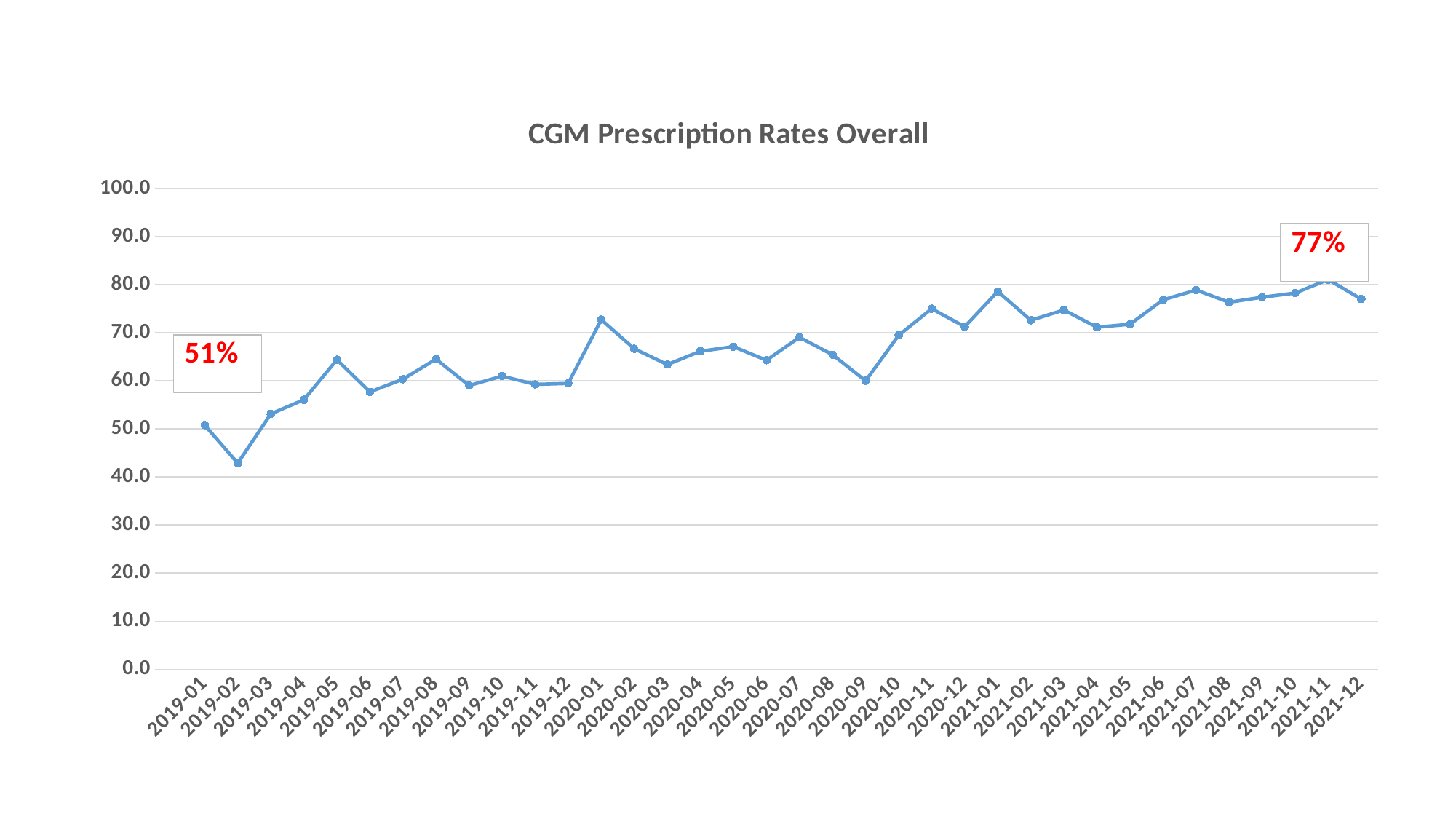
Which month has the lowest value on the chart? 2019-02 Is the value for 2019-05 greater or less than 60.0? greater How many monthly data points are plotted on the chart? 36 Is the value for 2020-01 greater or less than 70.0? greater By how many percentage points does the annotated value for 2021-12 exceed the annotated value for 2019-01? 26 Overall, do the values rise or fall from 2019-01 to 2021-12? rise What kind of chart is shown on the slide? line chart Which has the larger value, 2019-12 or 2020-01? 2020-01 Is the value for 2019-02 greater or less than 50.0? less What is the title of the chart? CGM Prescription Rates Overall What value is annotated for the first point, 2019-01? 51% What value is annotated for the last point, 2021-12? 77%